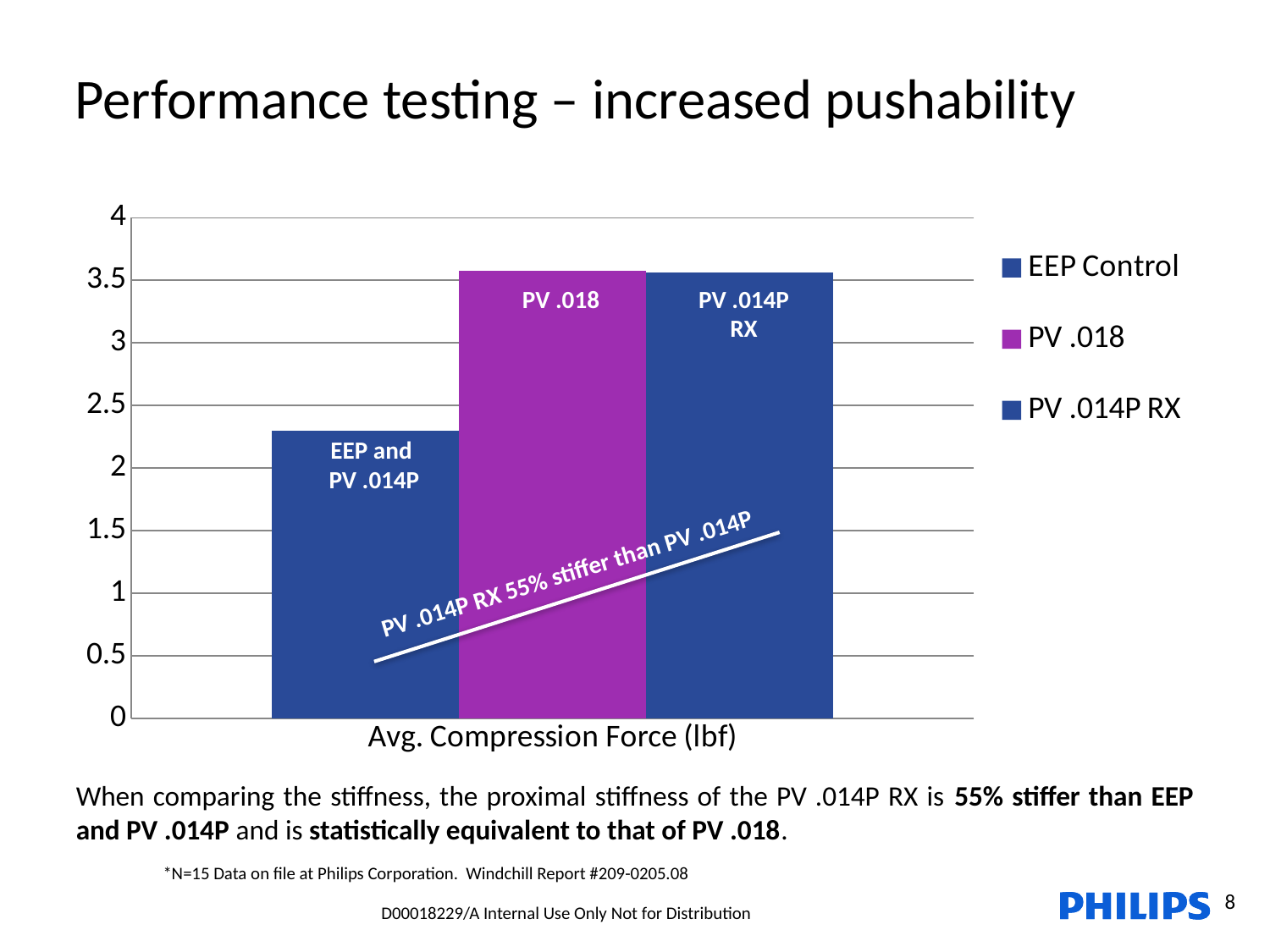
What kind of chart is shown on the slide? bar chart Is the value for PV .014P RX greater or less than 3? greater Which is larger, the value for EEP Control or the value for PV .014P RX? PV .014P RX Is the value for EEP Control greater or less than 2? greater How many categories are shown on the x axis? 1 What is the label of the category on the x axis? Avg. Compression Force (lbf) Is the value for PV .018 greater or less than 3.5? greater How many series does the legend list? 3 Which is larger, the value for PV .018 or the value for EEP Control? PV .018 Which series is shown in purple? PV .018 Which series has the lowest average compression force? EEP Control